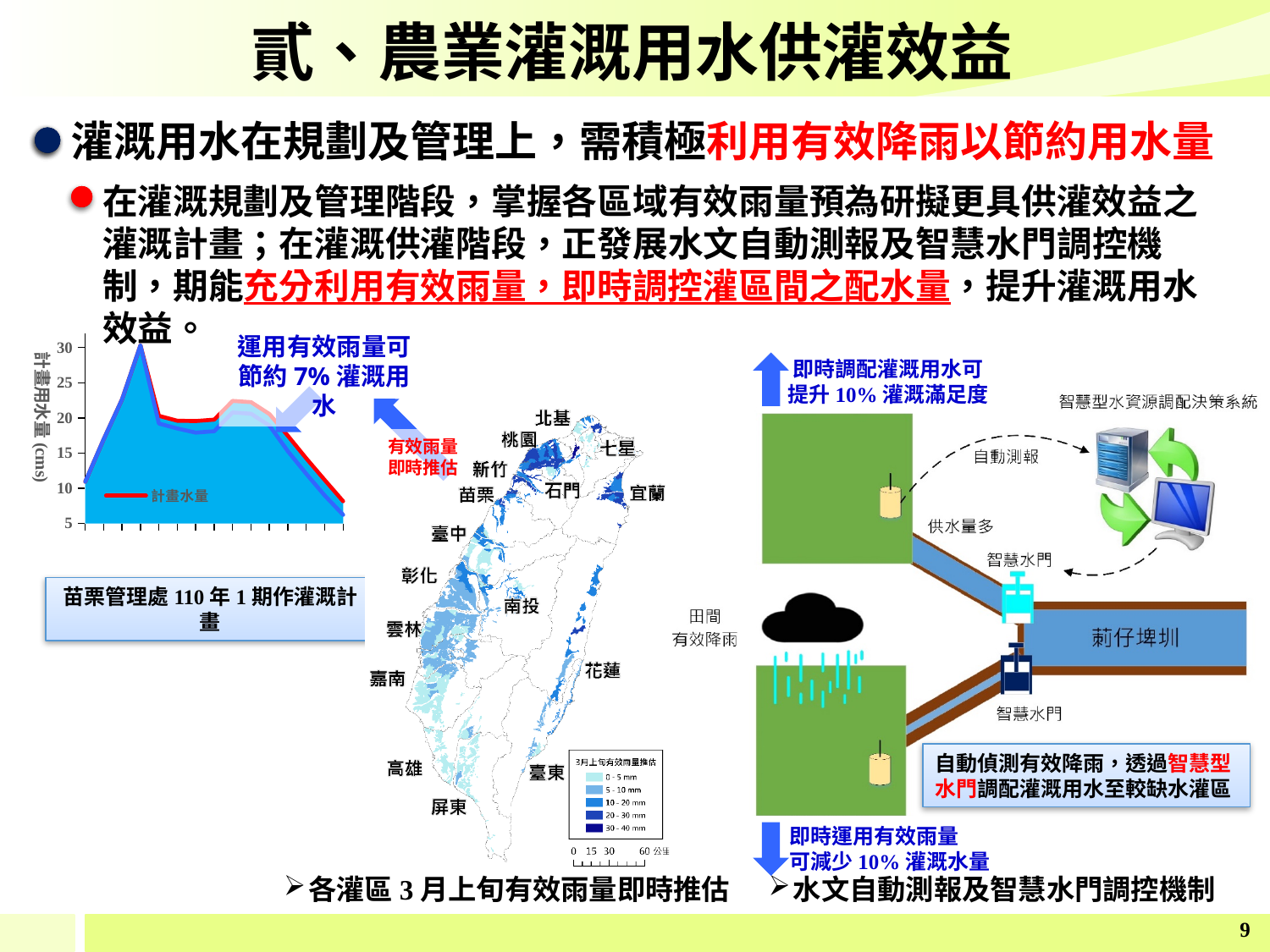
In the chart at the left of the slide, is the value of 計畫水量 at the right end of the x axis greater or less than 10? less What is the lowest tick value shown on the vertical axis of the chart at the left of the slide? 5 What is the highest tick value shown on the vertical axis of the chart at the left of the slide? 30 What is the name of the series shown in the legend of the chart at the left of the slide? 計畫水量 What is the label on the vertical axis of the chart at the left of the slide? 計畫用水量 (cms) How many series does the legend of the chart at the left of the slide list? 1 What kind of chart is shown at the left of the slide, below the bullet text? area chart In the chart at the left of the slide, is the peak value of 計畫水量 greater or less than 25? greater In the chart at the left of the slide, do the values of 計畫水量 rise or fall from the peak toward the right end of the x axis? fall